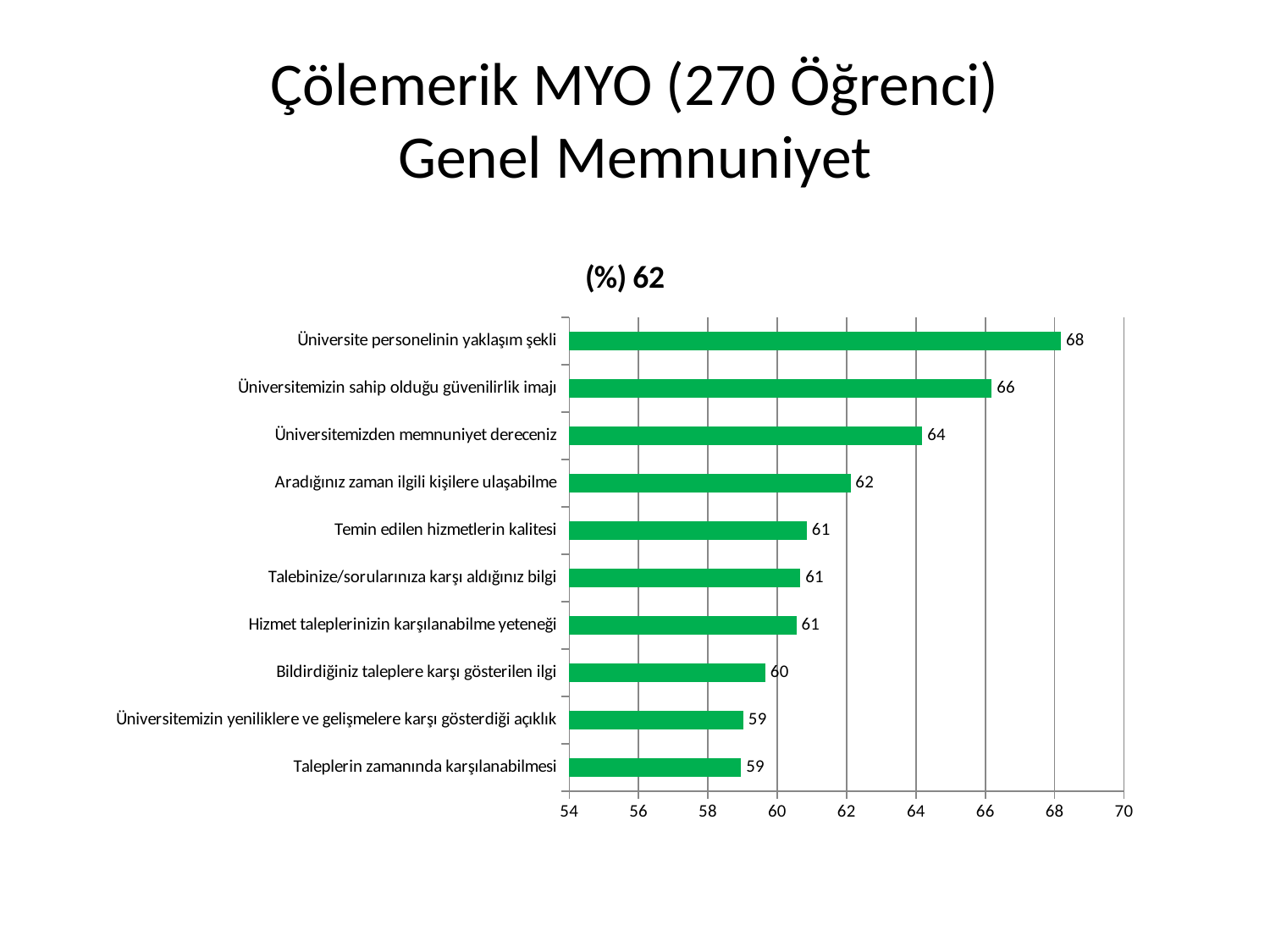
What is the value for "Bildirdiğiniz taleplere karşı gösterilen ilgi"? 60 Is the value for "Üniversitemizin yeniliklere ve gelişmelere karşı gösterdiği açıklık" greater or less than 60? less Which is larger, the value for "Üniversitemizin sahip olduğu güvenilirlik imajı" or the value for "Bildirdiğiniz taleplere karşı gösterilen ilgi"? Üniversitemizin sahip olduğu güvenilirlik imajı What is the value for "Üniversite personelinin yaklaşım şekli"? 68 What is the value for "Aradığınız zaman ilgili kişilere ulaşabilme"? 62 What kind of chart is shown on the slide? bar chart What is the value for "Üniversitemizden memnuniyet dereceniz"? 64 How many categories are shown in the chart? 10 What is the difference between the values for "Üniversite personelinin yaklaşım şekli" and "Taleplerin zamanında karşılanabilmesi"? 9 What is the title of the chart? (%) 62 Which category has the highest value? Üniversite personelinin yaklaşım şekli What is the difference between the values for "Üniversitemizin sahip olduğu güvenilirlik imajı" and "Üniversitemizden memnuniyet dereceniz"? 2